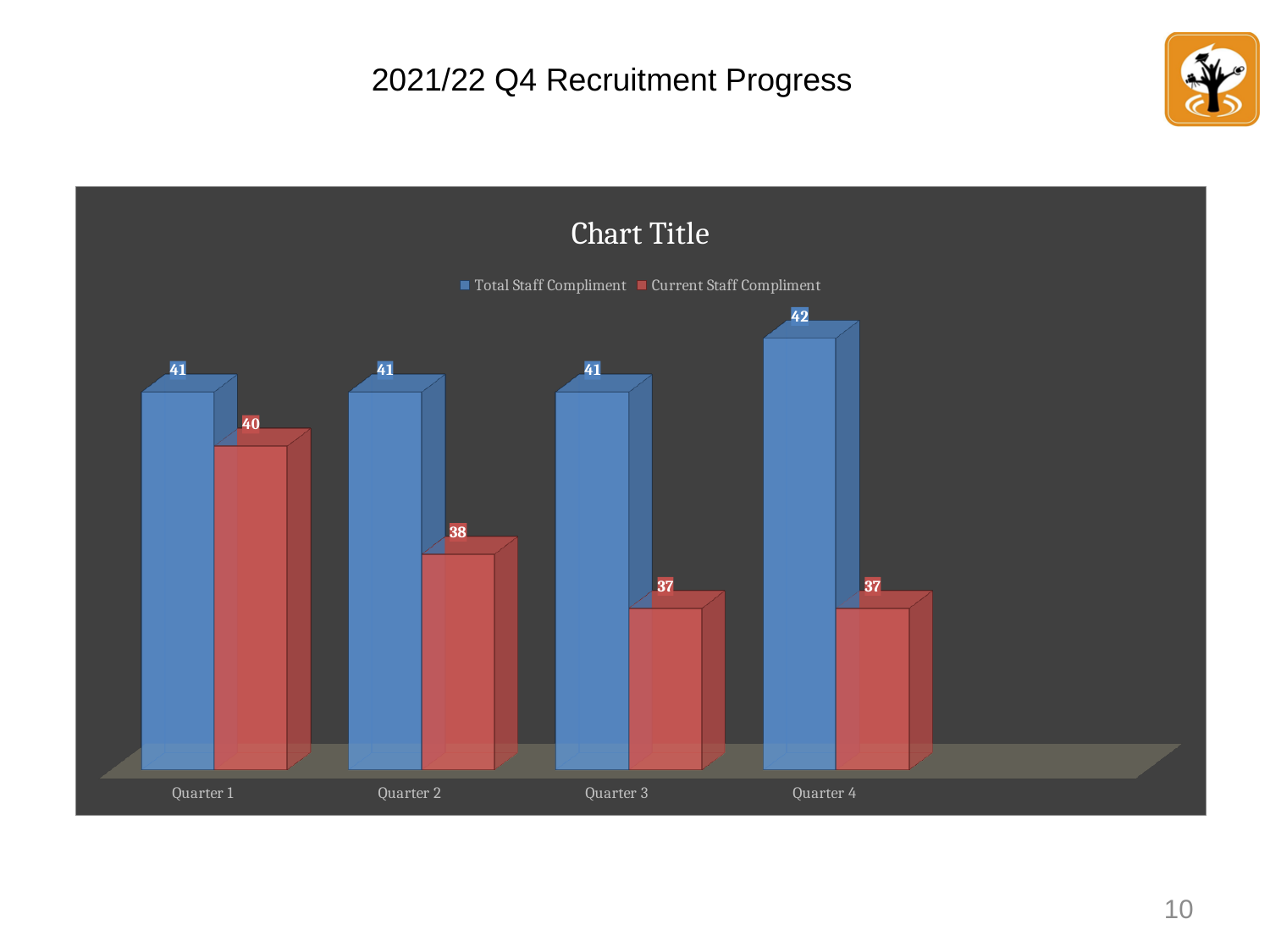
Which series is shown in red? Current Staff Compliment Which quarter has the highest Current Staff Compliment? Quarter 1 What is the Total Staff Compliment value for Quarter 4? 42 Which quarter has the highest Total Staff Compliment? Quarter 4 What is the difference between Total Staff Compliment and Current Staff Compliment in Quarter 1? 1 How many series does the legend list? 2 What is the difference between Total Staff Compliment and Current Staff Compliment in Quarter 4? 5 Which is larger, the Current Staff Compliment in Quarter 2 or in Quarter 3? Quarter 2 What is the Current Staff Compliment value for Quarter 2? 38 What kind of chart is shown on the slide? Bar chart What is the Current Staff Compliment value for Quarter 1? 40 How many quarters are shown on the x axis? 4